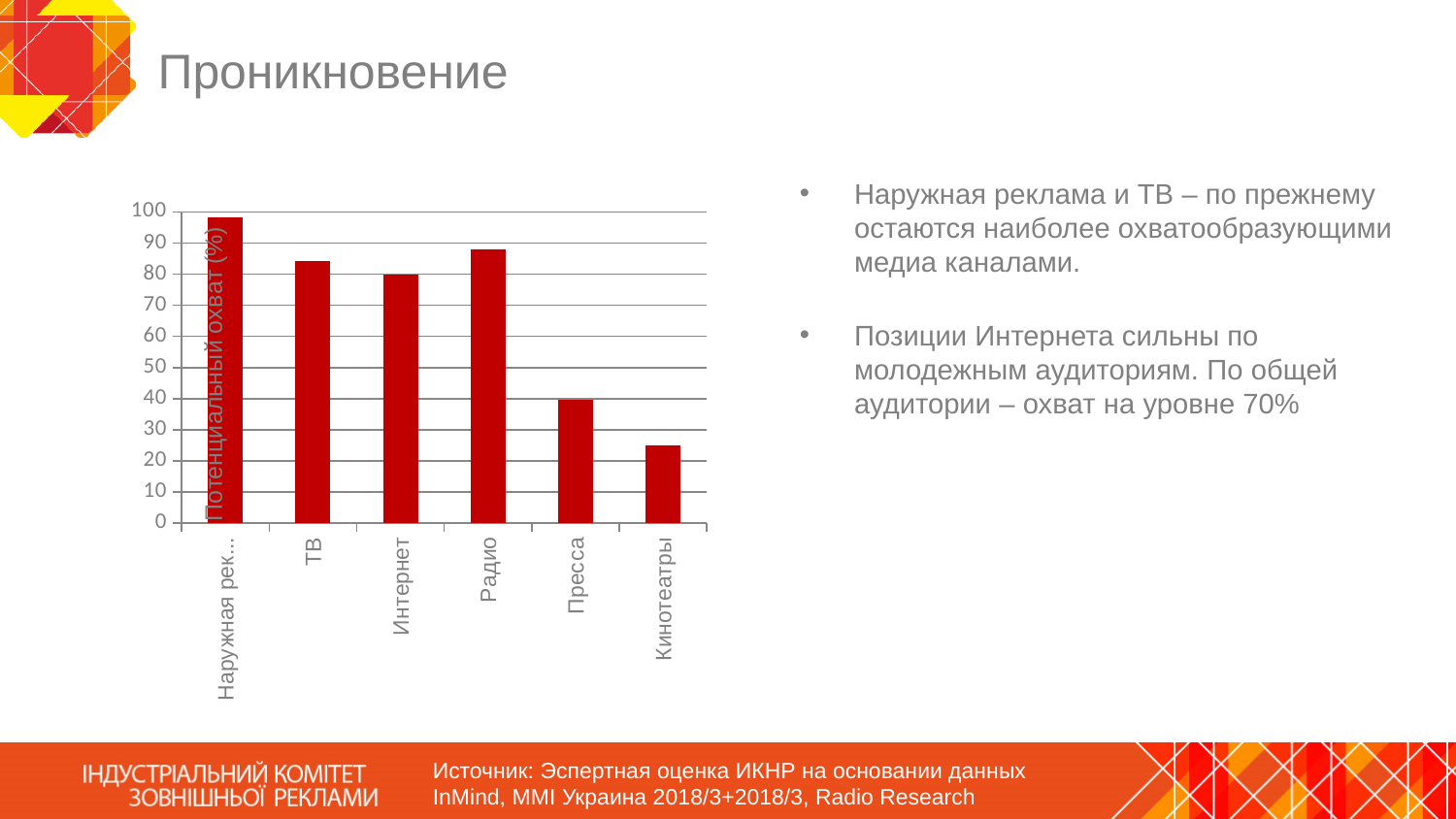
Is the value for Пресса greater or less than 50? less Which is larger, the value for Пресса or the value for Кинотеатры? Пресса What is the title of the vertical axis on the chart? Потенциальный охват (%) Is the value for Наружная рек... greater or less than 90? greater Which category has the lowest bar on the chart? Кинотеатры What kind of chart is shown on the slide? Bar chart How many categories are plotted on the chart? 6 Is the value for Пресса greater or less than 30? greater Which category has the highest bar on the chart? Наружная рек...